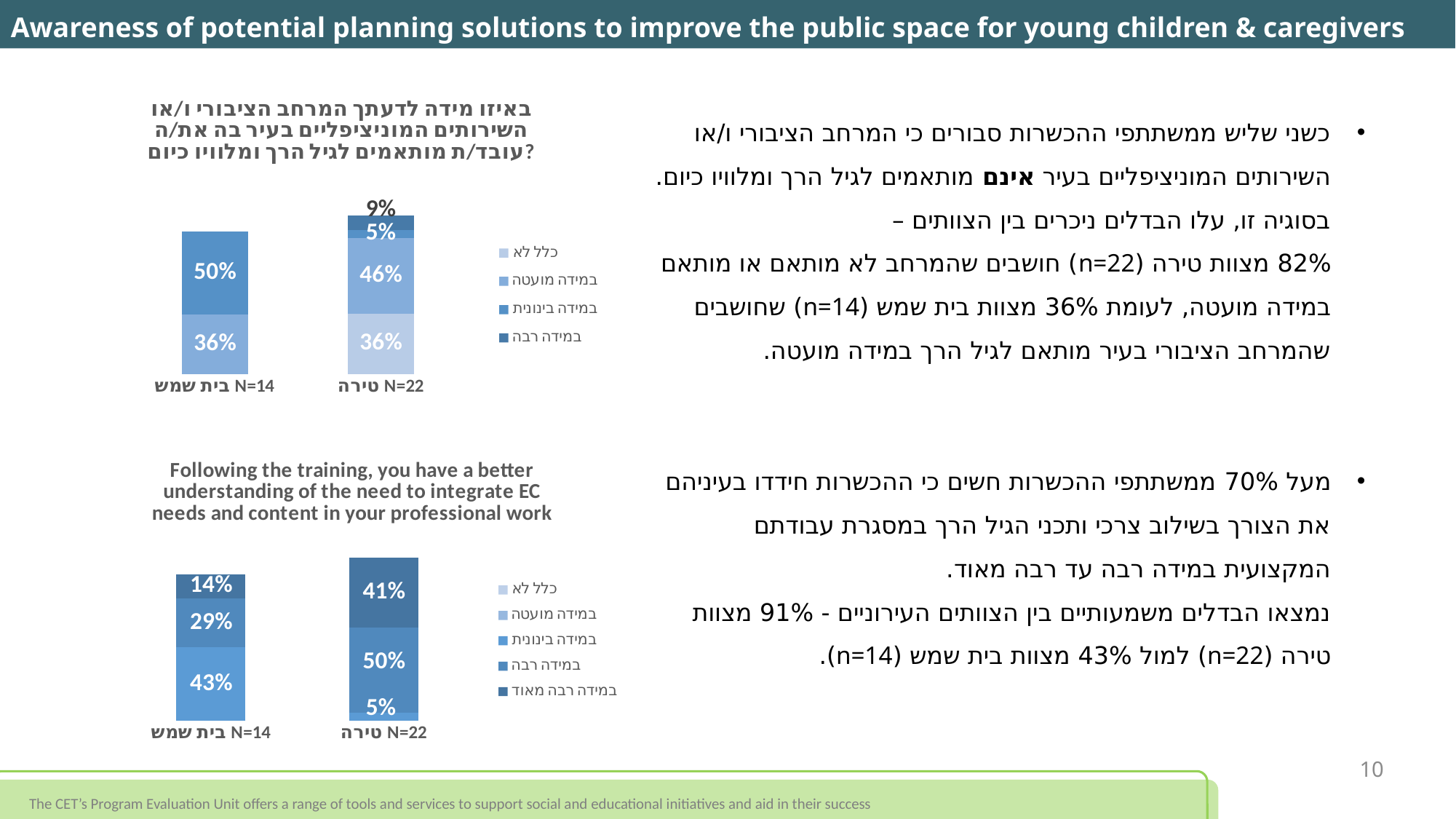
In the bottom chart, what is the total of the בית שמש N=14 bar (43% + 29% + 14%)? 86% In the top chart, what is the difference between the 50% segment of בית שמש N=14 and the 46% segment of טירה N=22? 4% In the bottom chart, what is the value of the bottom segment of the בית שמש N=14 bar? 43% In the top chart, what is the value of the bottom segment of the טירה N=22 bar? 36% In the top chart, what is the value of the topmost segment of the טירה N=22 bar? 9% In the bottom chart, what is the value of the largest segment of the טירה N=22 bar? 50% In the top chart, how many bars (categories) are shown? 2 In the bottom chart, which bar has the larger topmost segment, בית שמש N=14 (14%) or טירה N=22 (41%)? טירה N=22 What kind of chart is the top chart on the slide? stacked bar chart In the top chart, what is the value of the upper segment of the בית שמש N=14 bar? 50% In the top chart, how many entries does the legend list? 4 In the bottom chart, how many entries does the legend list? 5